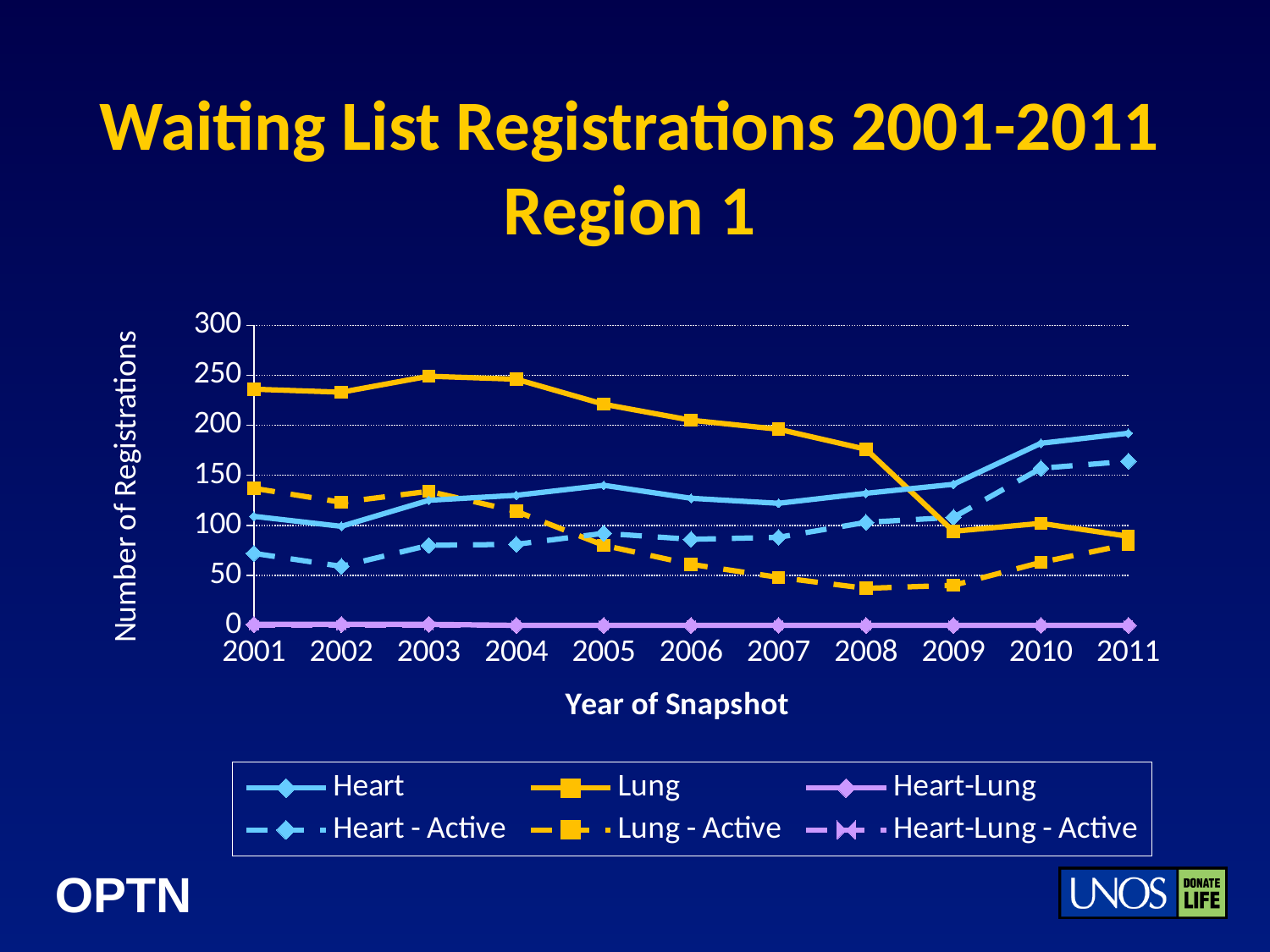
Is the value for Lung in 2003 greater or less than 200? greater How many series does the legend list? 6 What is the value for Heart-Lung in 2005? 0 Is the value for Lung in 2009 greater or less than 150? less How many years are plotted along the x axis? 11 Is the value for Heart in 2011 greater or less than 150? greater What is the label of the y axis? Number of Registrations In 2011, which is larger, Heart or Lung? Heart Do the Lung values generally rise or fall from 2001 to 2011? fall What kind of chart is shown on the slide? line chart In 2001, which is larger, Lung or Heart? Lung